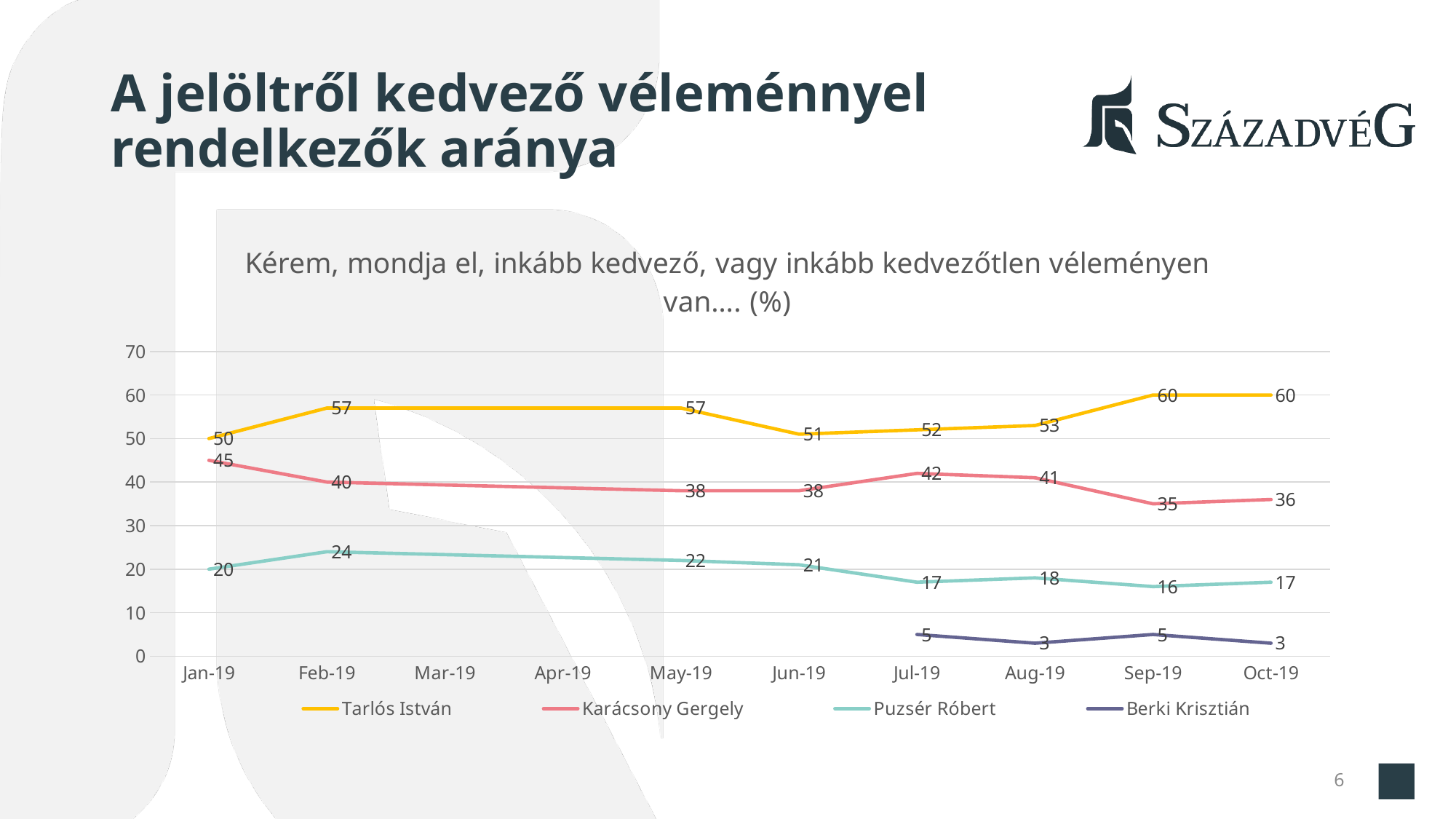
Which is larger in Jun-19: the value for Karácsony Gergely or the value for Puzsér Róbert? Karácsony Gergely What is the value for Karácsony Gergely in Jan-19? 45 What is the value for Tarlós István in Oct-19? 60 How many series does the legend list? 4 What is the difference between Tarlós István and Karácsony Gergely in Oct-19? 24 What is the value for Berki Krisztián in Aug-19? 3 Is the value for Tarlós István in Sep-19 greater or less than 50? greater What is the value for Puzsér Róbert in Feb-19? 24 In which month does Karácsony Gergely have his lowest value? Sep-19 Which series is shown in yellow? Tarlós István Does the value for Tarlós István rise or fall from Jun-19 to Oct-19? rise What kind of chart is shown on the slide? line chart